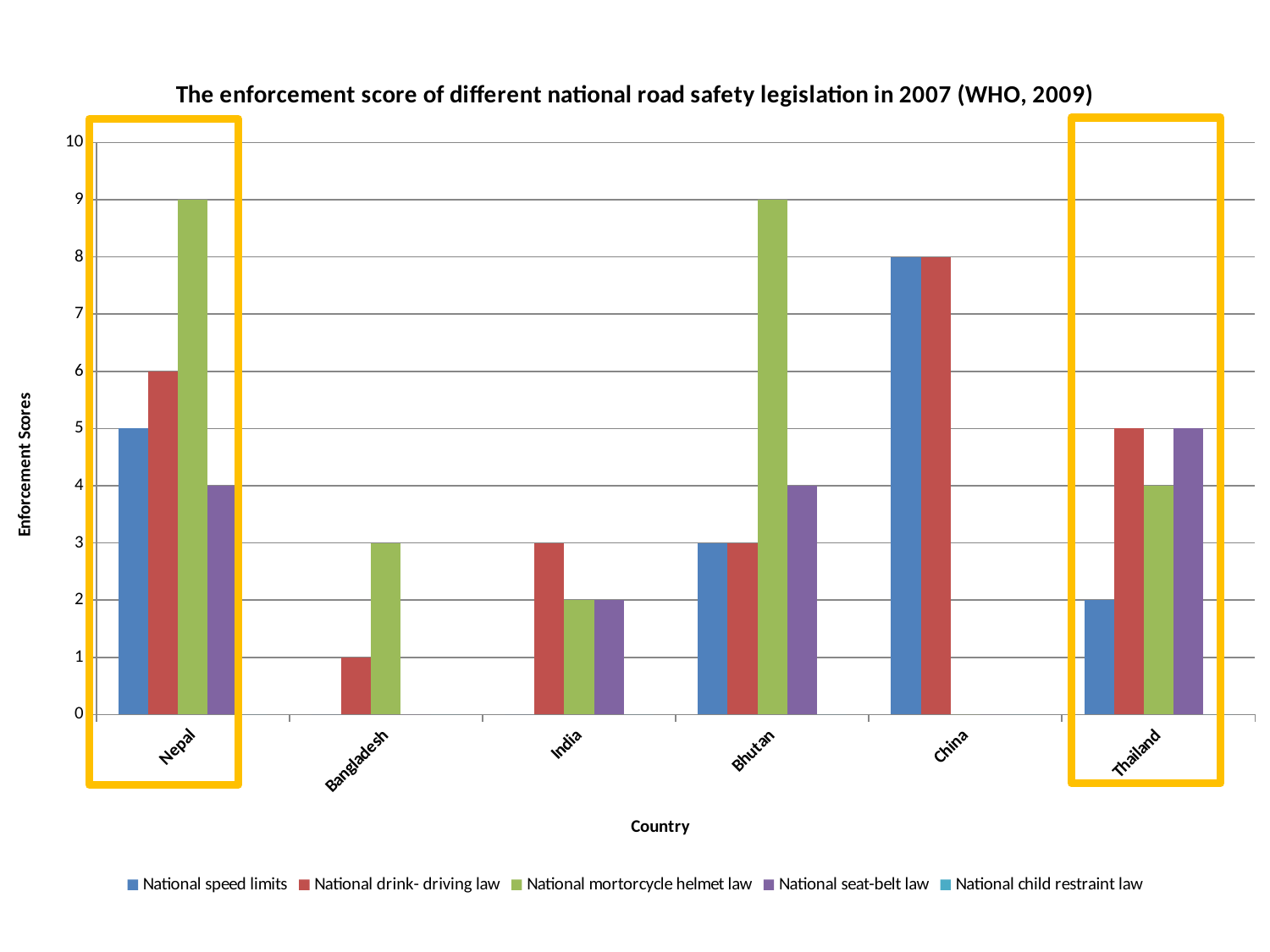
What is the enforcement score for the national motorcycle helmet law in Nepal? 9 Which country has the highest enforcement score for national speed limits? China Which country has the lowest enforcement score for the national drink-driving law? Bangladesh What is the enforcement score for the national drink-driving law in Thailand? 5 What is the enforcement score for the national drink-driving law in Bangladesh? 1 How many series does the legend list? 5 What kind of chart is shown on the slide? Bar chart What is the title of the chart? The enforcement score of different national road safety legislation in 2007 (WHO, 2009) How many countries are shown on the x axis? 6 Which is larger in Nepal: the national drink-driving law score or the national seat-belt law score? National drink-driving law What is the difference between the national motorcycle helmet law score in Bhutan and in India? 7 What is the enforcement score for national speed limits in China? 8